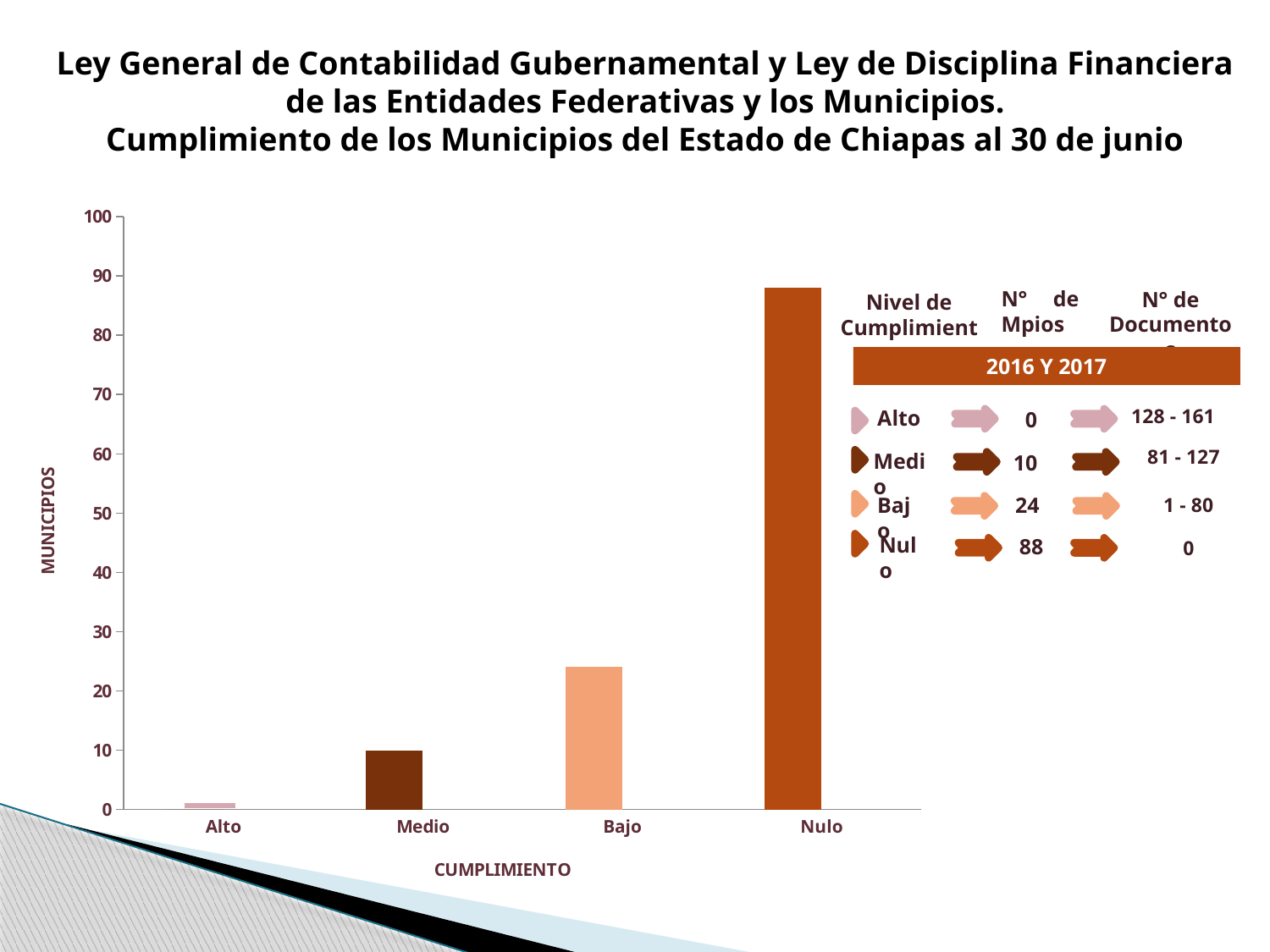
How many municipalities are in the Bajo category? 24 What is the difference between the number of municipalities in Nulo and in Medio? 78 Which has more municipalities, Bajo or Medio? Bajo Which compliance category has the highest number of municipalities? Nulo How many compliance categories are shown on the x axis of the chart? 4 How many municipalities are in the Medio category? 10 Is the value for Nulo greater or less than 80? greater What is the label of the vertical axis of the chart? MUNICIPIOS Which compliance category has the lowest number of municipalities? Alto Is the value for Bajo greater or less than 30? less What kind of chart is shown on the slide? bar chart How many municipalities are in the Nulo category? 88